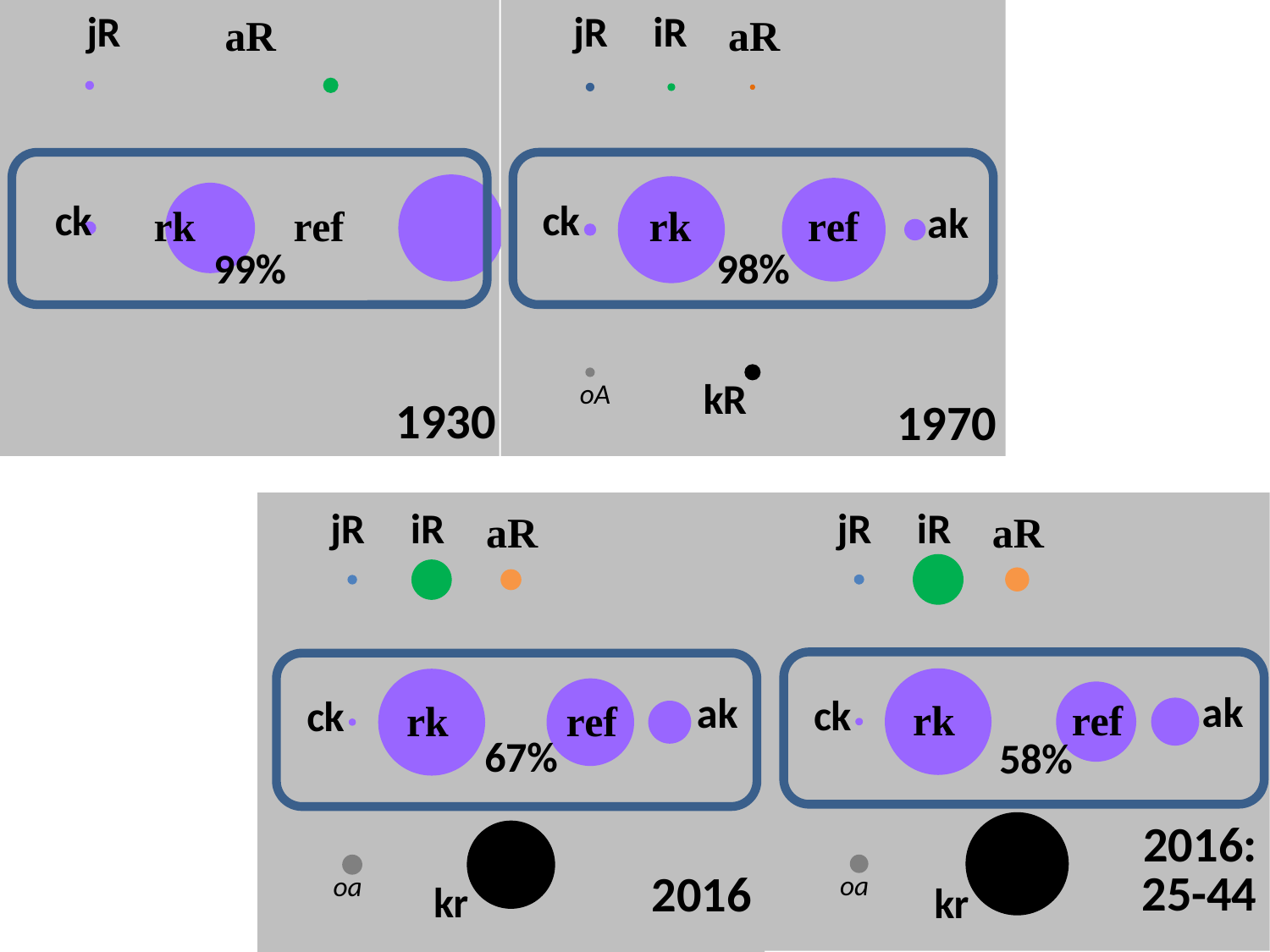
What kind of chart is used in each panel? bubble chart In the '2016: 25-44' panel, what percentage is printed inside the boxed group? 58% Which panel shows the lowest percentage for the boxed group? 2016: 25-44 Does the boxed-group percentage rise or fall from 1930 to 1970 to 2016? fall In the 1930 panel, what percentage is printed inside the boxed group? 99% How many year panels are shown on the slide? 4 In the 1970 panel, what percentage is printed inside the boxed group? 98% What is the difference between the boxed-group percentage in 1930 and in 2016? 32 percentage points Which panel shows the highest percentage for the boxed group? 1930 Is the boxed-group percentage larger in the 1970 panel or in the 2016 panel? 1970 What is the difference between the boxed-group percentage in the 2016 panel and the '2016: 25-44' panel? 9 percentage points In the 2016 panel, what percentage is printed inside the boxed group? 67%